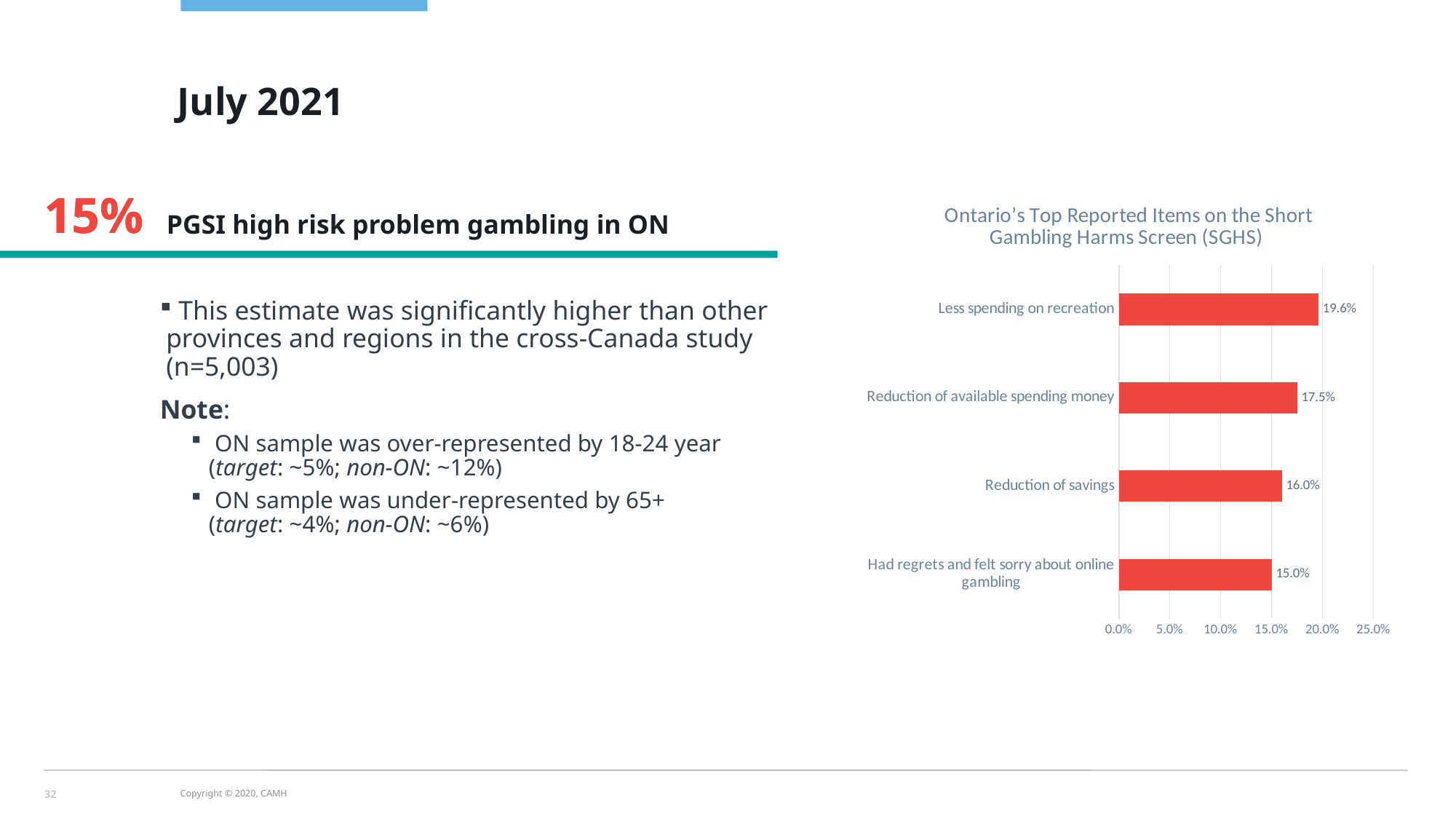
What kind of chart is shown on the slide? Bar chart Which is larger: "Reduction of available spending money" or "Reduction of savings"? Reduction of available spending money What is the difference between "Reduction of available spending money" and "Had regrets and felt sorry about online gambling"? 2.5% How many items are shown in the chart? 4 Which item has the lowest value? Had regrets and felt sorry about online gambling What is the difference between "Less spending on recreation" and "Reduction of savings"? 3.6% Which item has the highest value? Less spending on recreation What is the value for "Had regrets and felt sorry about online gambling"? 15.0% What is the value for "Reduction of available spending money"? 17.5% What is the title of the chart? Ontario's Top Reported Items on the Short Gambling Harms Screen (SGHS) What is the value for "Reduction of savings"? 16.0% What is the value for "Less spending on recreation"? 19.6%